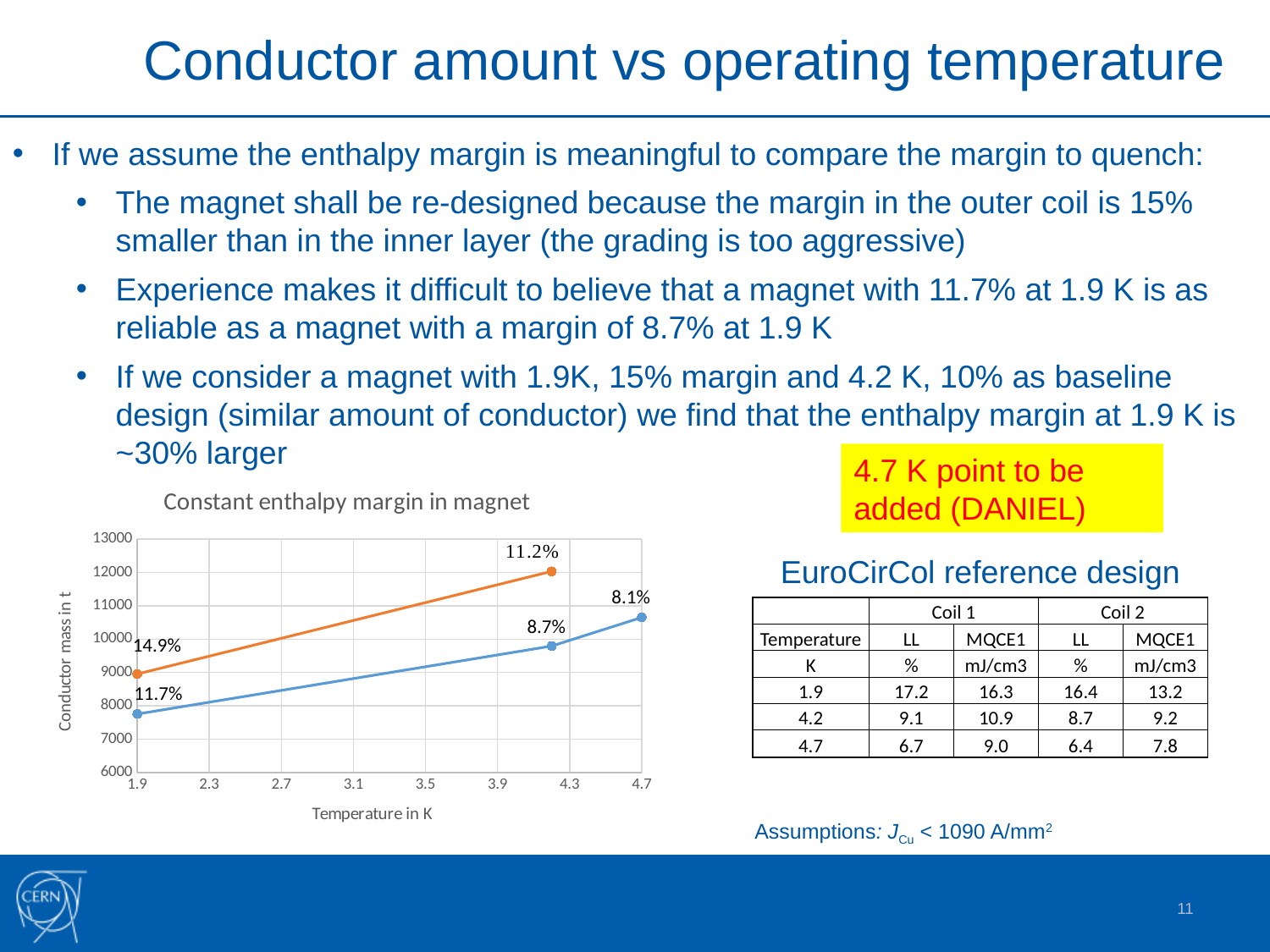
What kind of chart is shown on the slide? line chart Is the conductor mass on the blue line at 1.9 K greater or less than 8000? less At 1.9 K, which line shows the larger conductor mass, the orange or the blue? orange What data label is shown on the blue line at 4.7 K? 8.1% How many data points are plotted on the orange line? 2 What data label is shown on the orange line at its right-hand point (around 4.2 K)? 11.2% What is the title of the chart? Constant enthalpy margin in magnet What data label is shown on the blue line at 1.9 K? 11.7% How many data points are plotted on the blue line? 3 What data label is shown on the orange line at 1.9 K? 14.9% Does the conductor mass on the blue line rise or fall as temperature increases? rise What is the label of the vertical axis of the chart? Conductor mass in t